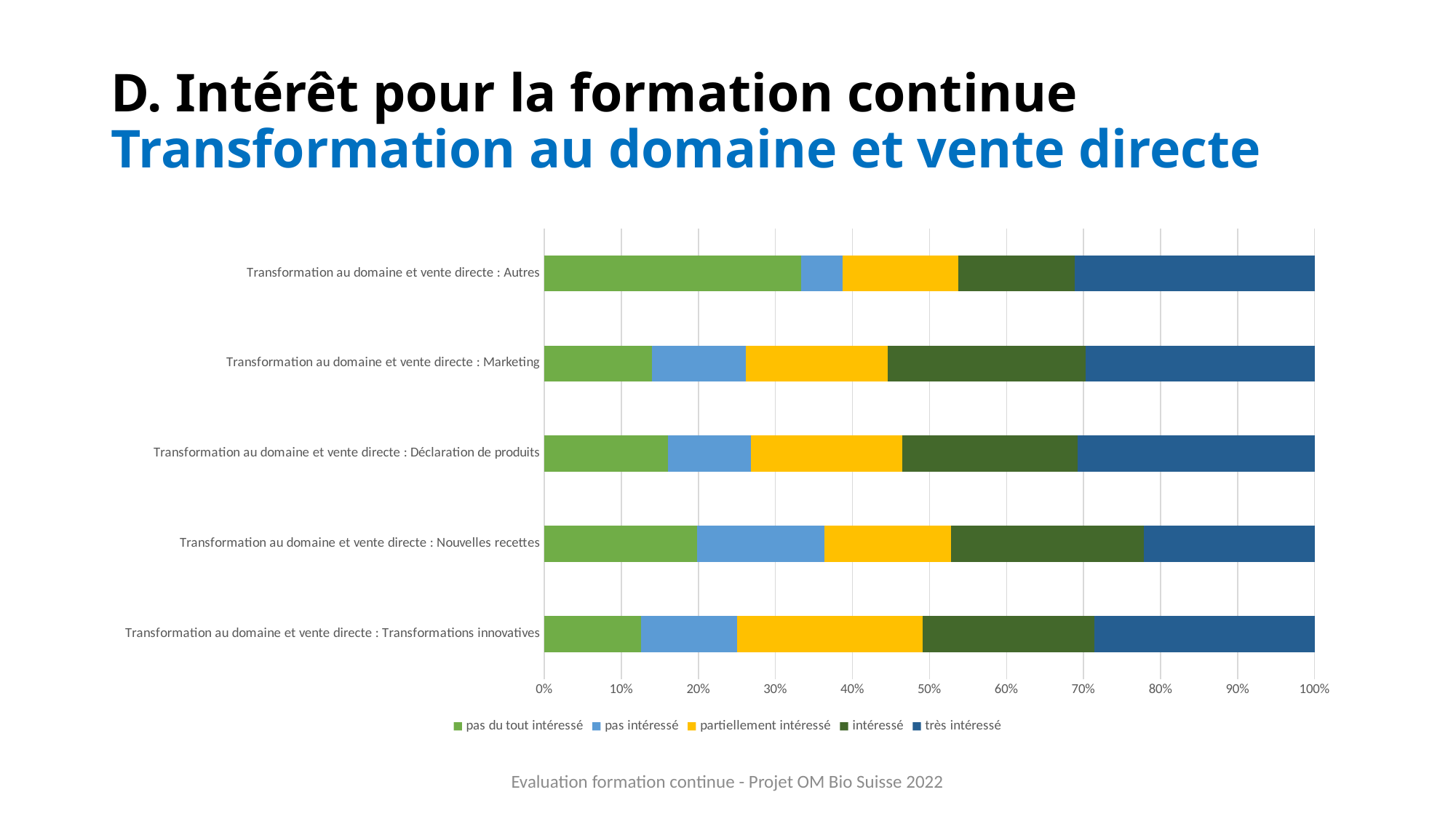
Is the 'très intéressé' share for 'Transformation au domaine et vente directe : Nouvelles recettes' greater or less than 30%? less What kind of chart is shown on the slide? Stacked bar chart How many categories (bars) are plotted in the chart? 5 Is the 'pas du tout intéressé' share for 'Transformation au domaine et vente directe : Autres' greater or less than 30%? greater Which has the larger 'intéressé' share: 'Marketing' or 'Autres'? Transformation au domaine et vente directe : Marketing Which category has the largest 'partiellement intéressé' share? Transformation au domaine et vente directe : Transformations innovatives Is the 'pas du tout intéressé' share for 'Transformation au domaine et vente directe : Transformations innovatives' greater or less than 20%? less What colour represents the 'très intéressé' series in the chart? Dark blue Which category has the largest 'pas du tout intéressé' share? Transformation au domaine et vente directe : Autres How many series does the legend list? 5 Which category has the smallest 'très intéressé' share? Transformation au domaine et vente directe : Nouvelles recettes Which has the larger 'pas intéressé' share: 'Nouvelles recettes' or 'Autres'? Transformation au domaine et vente directe : Nouvelles recettes